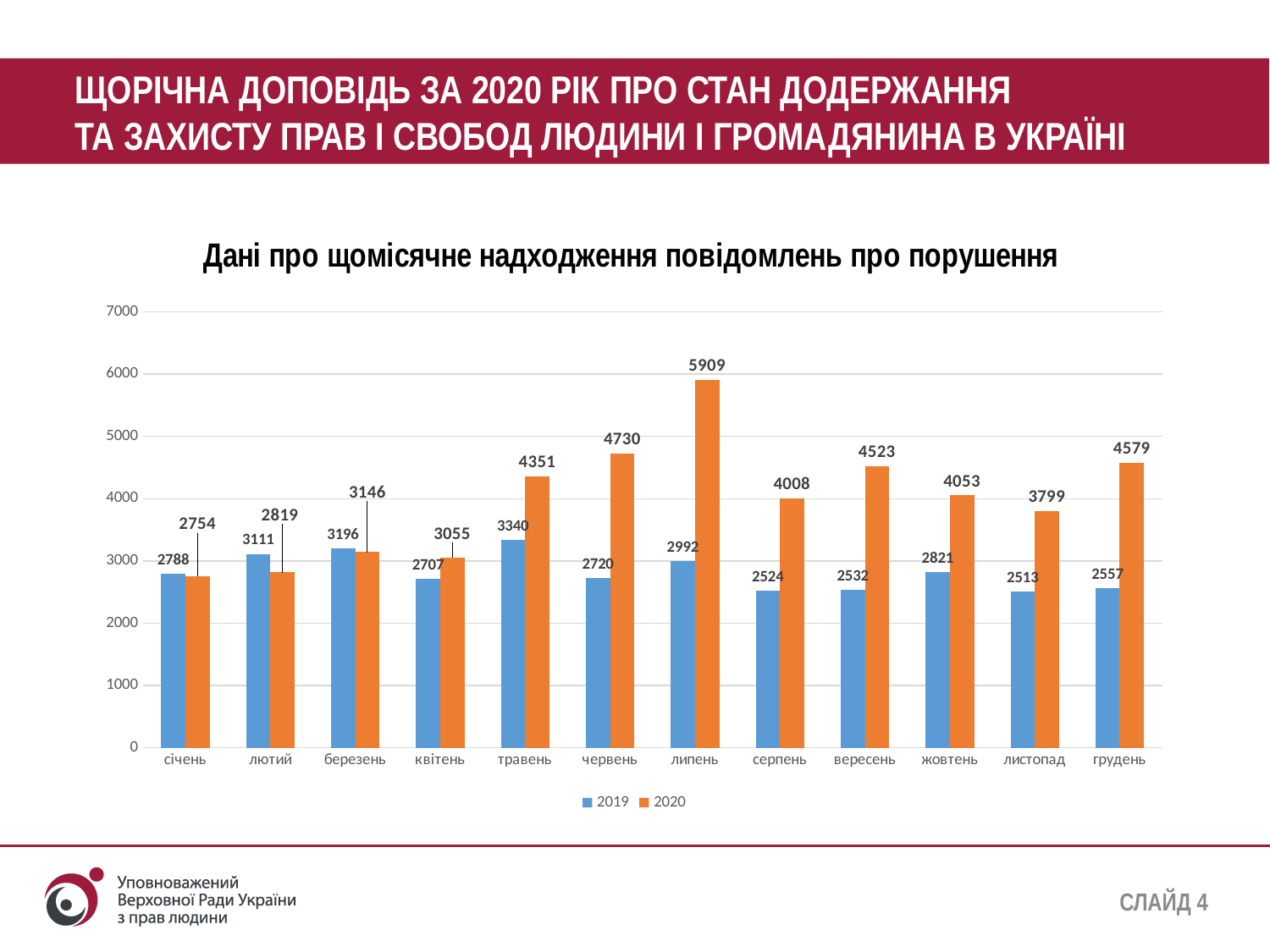
What is the value for 2019 in травень? 3340 What is the difference between the 2020 and 2019 values in липень? 2917 Is the value for 2020 in червень greater or less than 4000? greater How many months are shown on the x axis? 12 What is the title of the chart? Дані про щомісячне надходження повідомлень про порушення Which is larger in лютий: the 2019 value or the 2020 value? 2019 Which month has the lowest value for the 2019 series? листопад What is the value for 2020 in липень? 5909 How many series does the legend list? 2 What kind of chart is shown on the slide? bar chart Which month has the highest value for the 2020 series? липень What colour are the bars for the 2020 series? orange